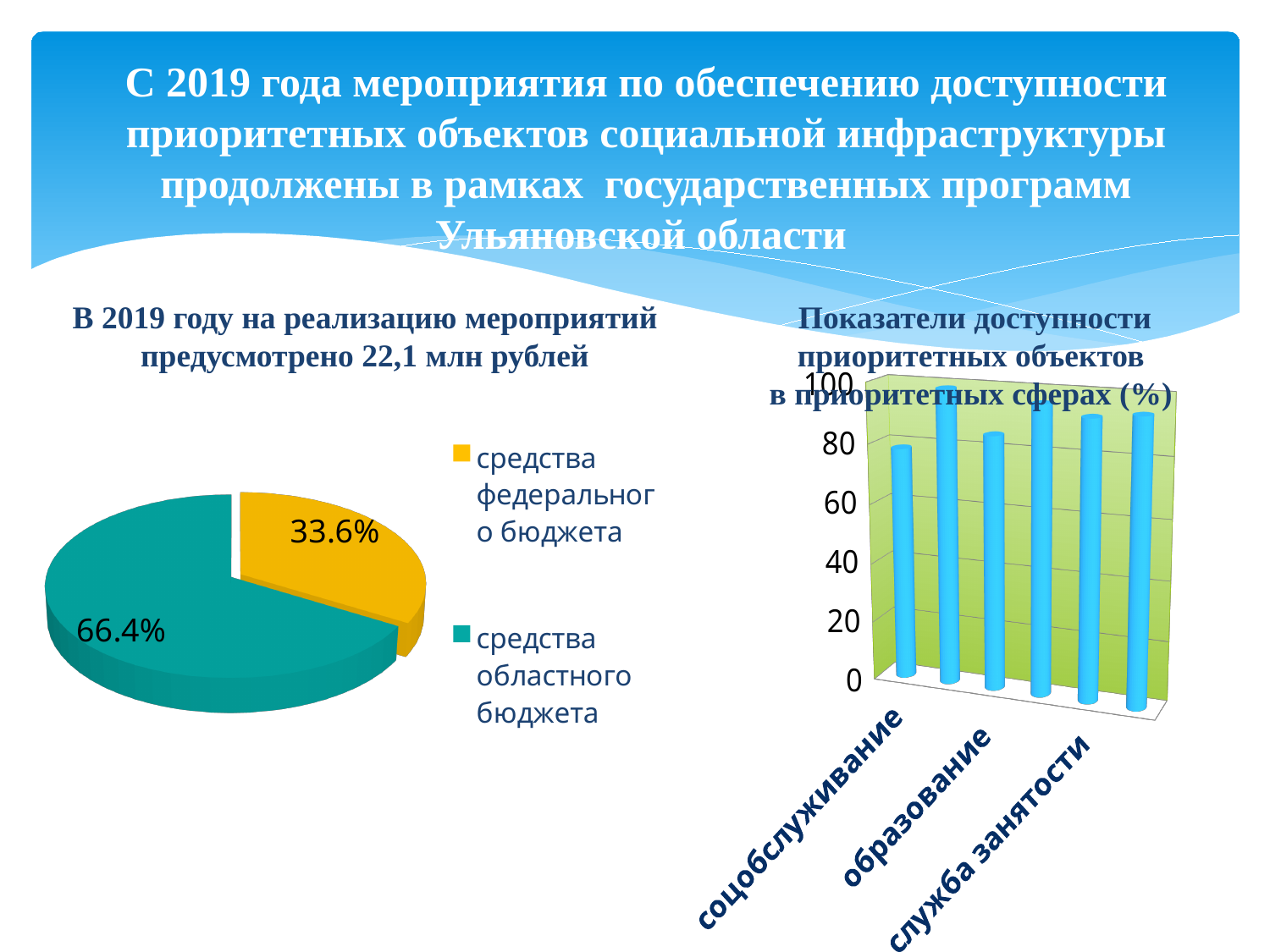
On the pie chart on the left, what colour is the slice for средства федерального бюджета? yellow On the bar chart on the right, is the value of the tallest bar greater or less than 80? greater On the pie chart on the left, which slice is the largest? средства областного бюджета On the pie chart on the left, what share is labelled for средства областного бюджета? 66.4% On the pie chart on the left, which slice is the smallest? средства федерального бюджета How many bars are plotted on the bar chart on the right of the slide? 6 On the pie chart on the left, which is larger: the share for средства федерального бюджета or for средства областного бюджета? средства областного бюджета How many slices does the pie chart on the left have? 2 What kind of chart is the chart on the left of the slide? pie chart On the pie chart on the left, what is the difference in percentage points between the областного бюджета slice and the федерального бюджета slice? 32.8 What kind of chart is the chart on the right of the slide (Показатели доступности приоритетных объектов)? bar chart On the pie chart on the left, what share is labelled for средства федерального бюджета? 33.6%